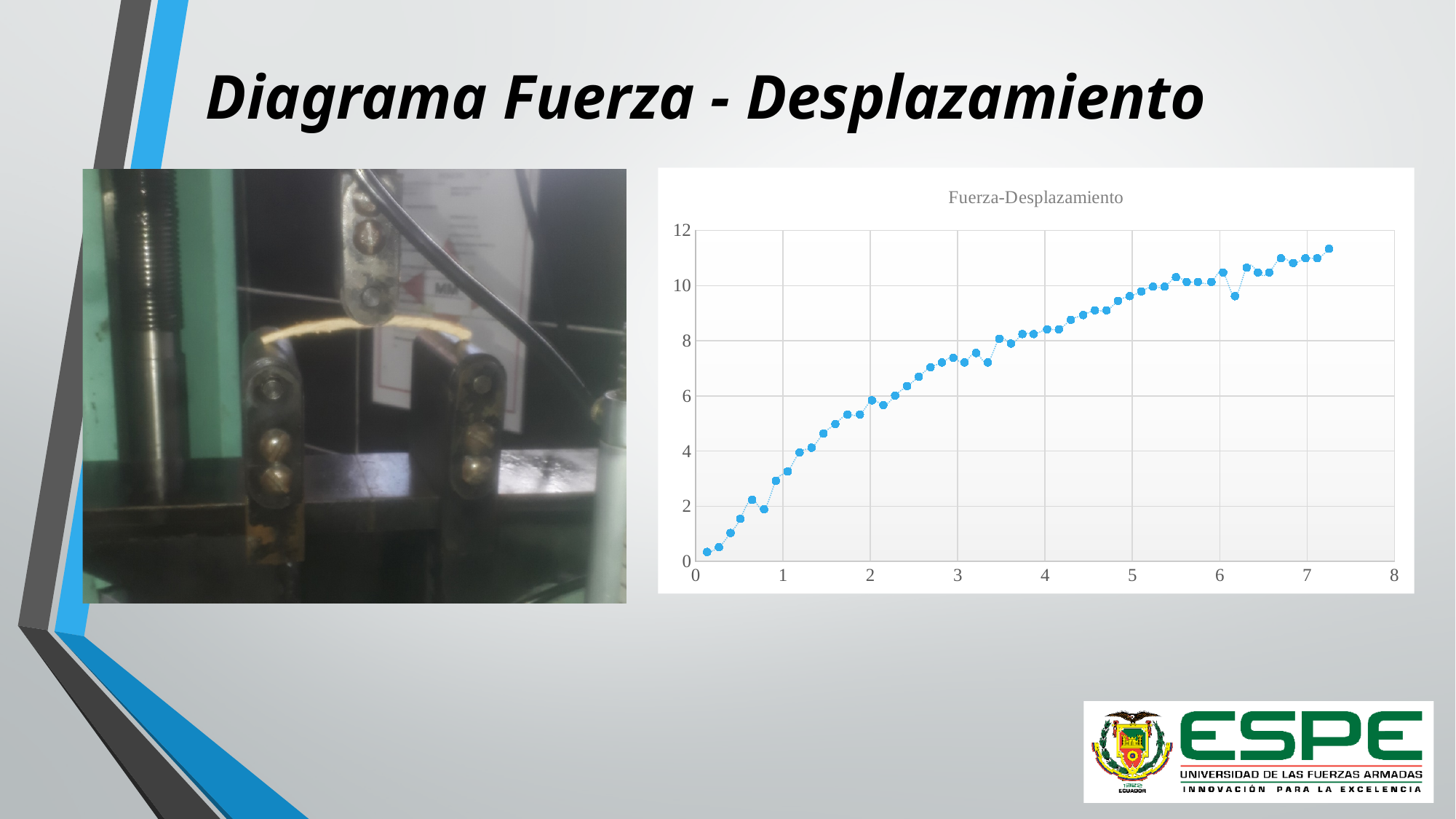
Is the value of the rightmost point (near x = 7.3) greater or less than 10? greater What is the title of the chart on the slide? Fuerza-Desplazamiento Which point has the higher value: the leftmost point or the rightmost point? The rightmost point Is the value of the point near x = 4 greater or less than 6? greater Is the value of the point near x = 6 greater or less than 12? less Where along the x axis is the highest plotted value located: near the left end or near the right end? Near the right end What is the highest tick value shown on the y axis? 12 What kind of chart is shown on the slide? Scatter chart Do the plotted values generally rise or fall as the x-axis value increases? Rise